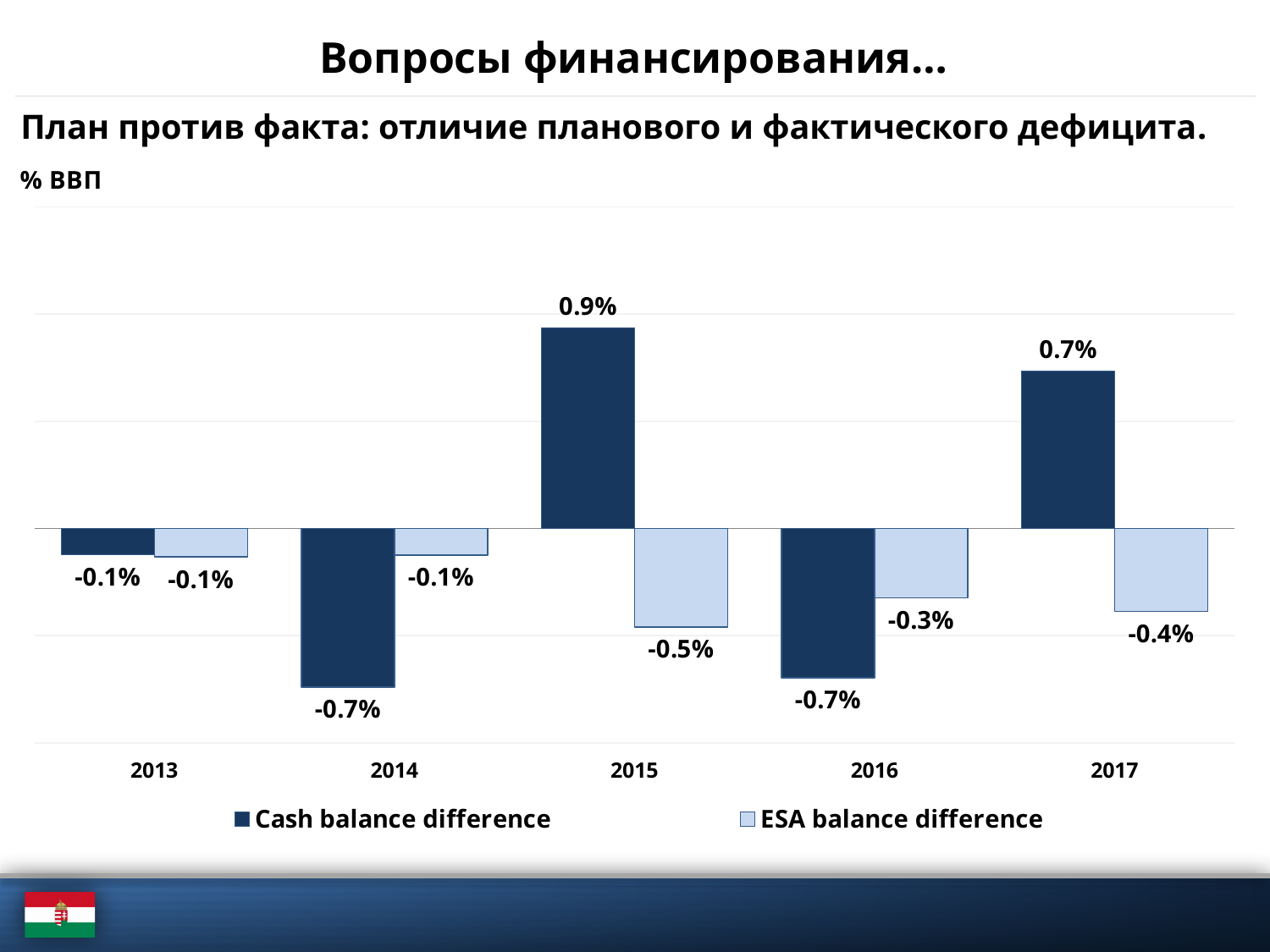
What is the Cash balance difference for 2014? -0.7% What is the Cash balance difference for 2015? 0.9% How many series does the legend list? 2 What unit is indicated above the chart? % ВВП In which year is the Cash balance difference highest? 2015 What is the ESA balance difference for 2016? -0.3% What kind of chart is shown on the slide? Bar chart In which year is the ESA balance difference lowest? 2015 How many years are shown on the x axis? 5 What is the difference between the Cash balance difference in 2015 and in 2017? 0.2% What is the ESA balance difference for 2017? -0.4% Which is larger in 2016: the Cash balance difference or the ESA balance difference? ESA balance difference